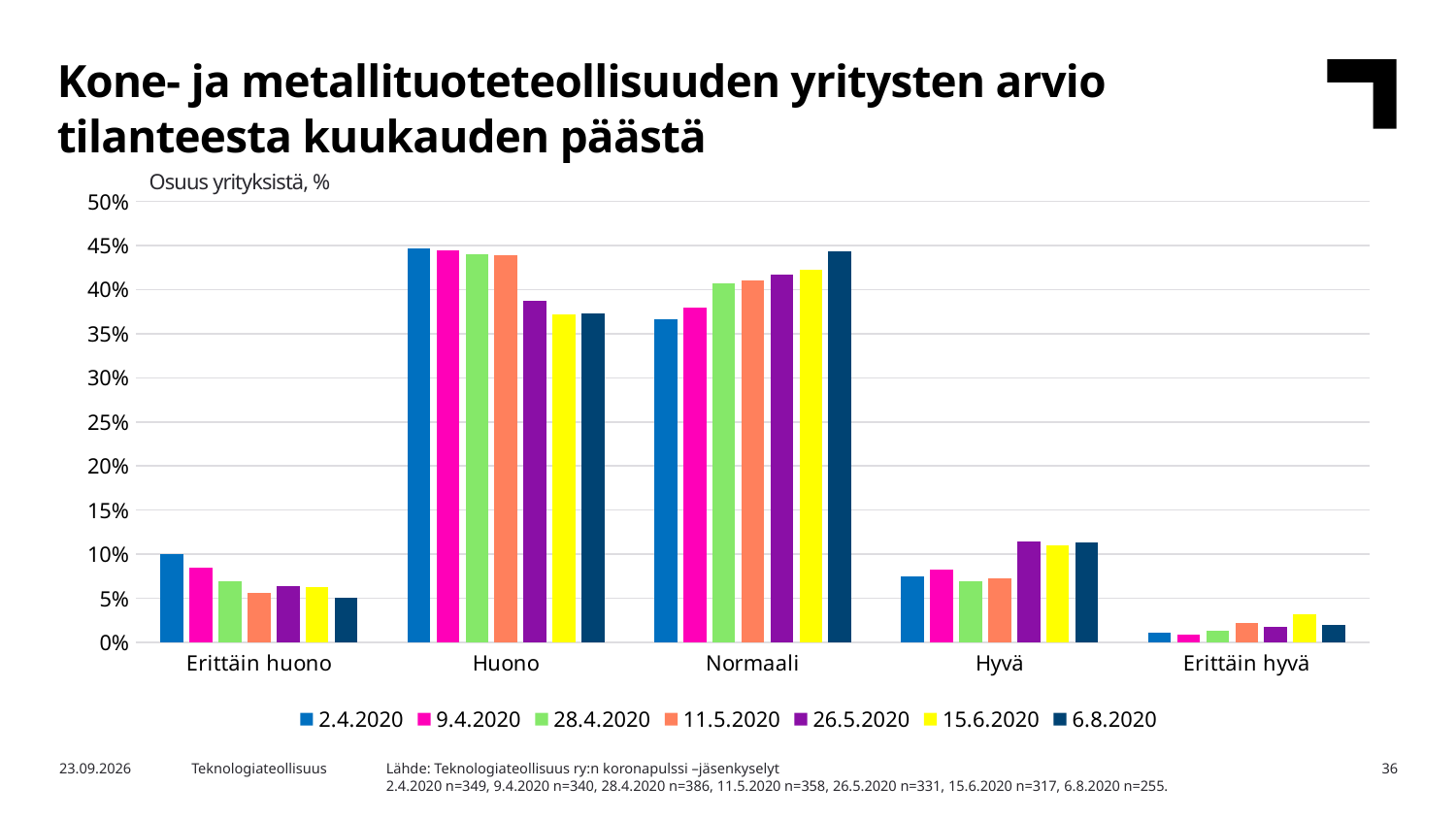
Do the values for Normaali rise or fall across the survey dates from 2.4.2020 to 6.8.2020? rise For the 2.4.2020 series, which is larger: Huono or Normaali? Huono Is the value for Erittäin huono on 2.4.2020 greater or less than 15%? less How many series does the legend list? 7 Which category has the lowest value for the 2.4.2020 series? Erittäin hyvä Is the value for Huono on 2.4.2020 greater or less than 40%? greater Is the value for Erittäin hyvä on 15.6.2020 greater or less than 5%? less What kind of chart is shown on the slide? bar chart How many categories are shown on the x axis? 5 Which category has the highest value for the 6.8.2020 series? Normaali Which category has the highest value for the 2.4.2020 series? Huono